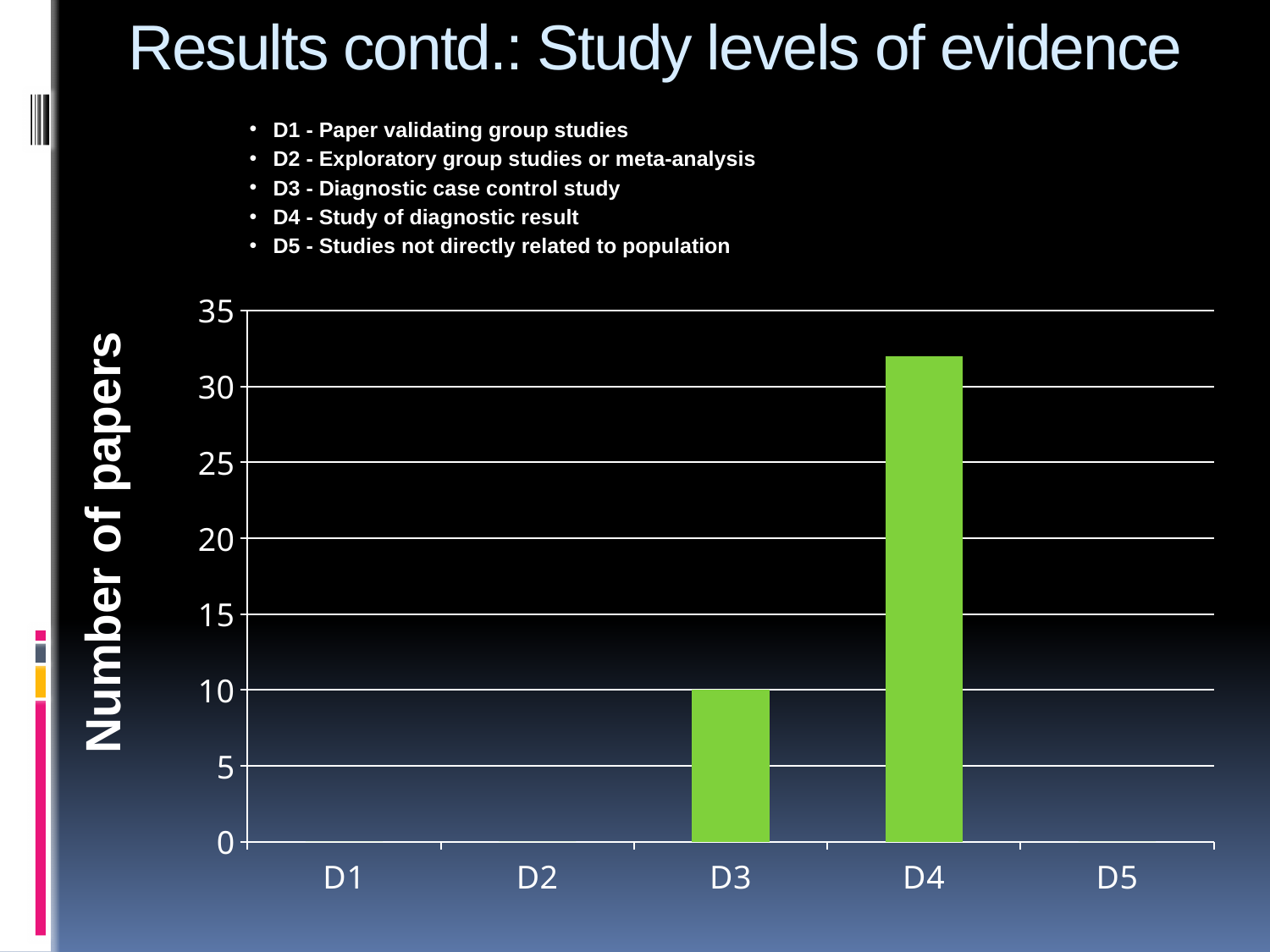
Is the number of papers for D3 greater or less than 15? less How many categories have a visible bar in the chart? 2 Which category has the highest number of papers? D4 Is the number of papers for D1 greater or less than 5? less What kind of chart is shown on the slide? bar chart Which has more papers, D3 or D4? D4 What colour are the bars in the chart? green Is the number of papers for D4 greater or less than 30? greater How many categories are shown on the x axis of the chart? 5 What is the number of papers for D3? 10 What is the label of the vertical axis of the chart? Number of papers